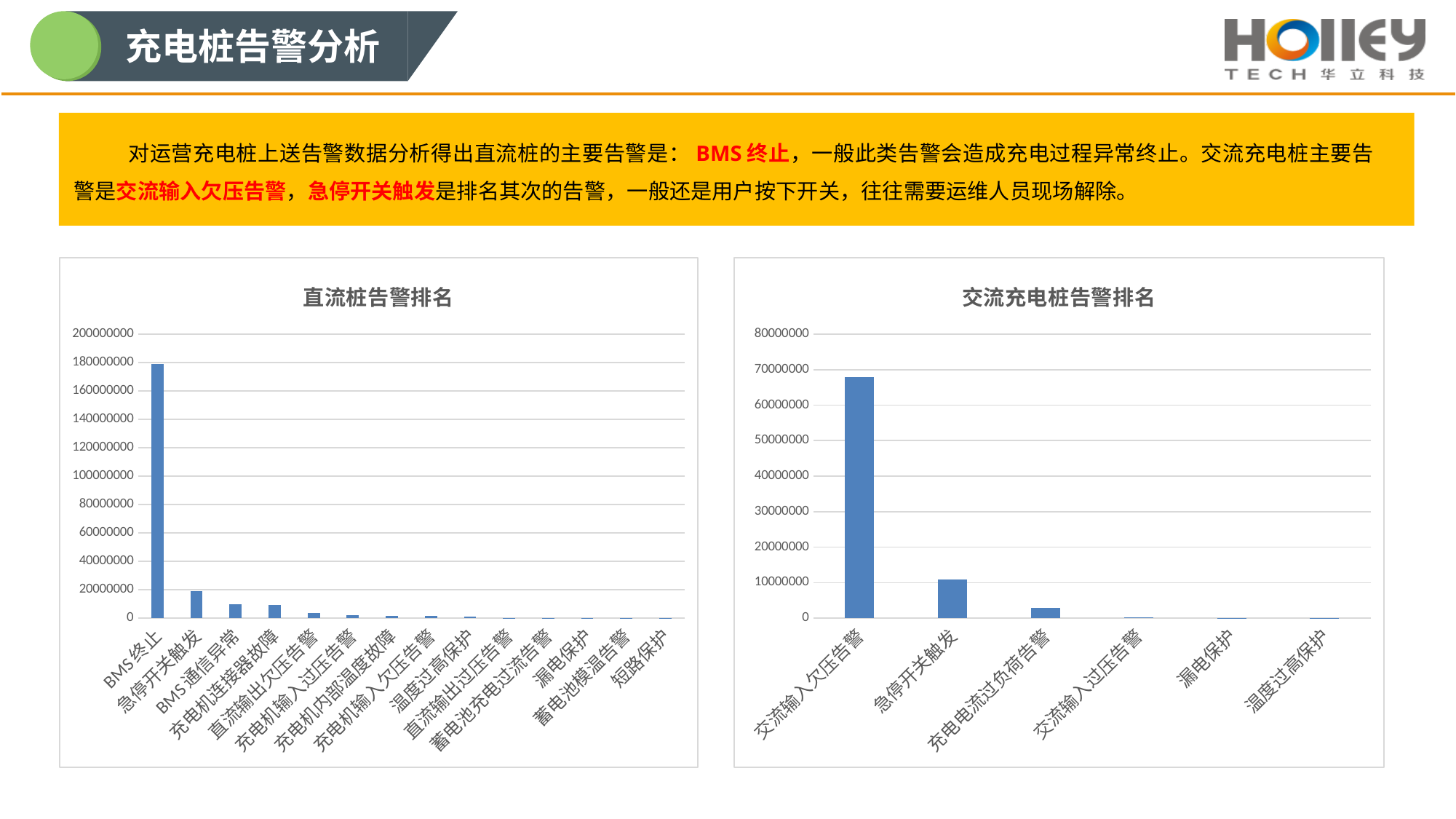
In the 直流桩告警排名 chart on the left, do the values rise or fall from left to right along the x axis? fall What kind of chart is the 直流桩告警排名 chart on the left? bar chart In the 直流桩告警排名 chart on the left, which is larger, 急停开关触发 or BMS通信异常? 急停开关触发 In the 交流充电桩告警排名 chart on the right, which category has the highest value? 交流输入欠压告警 In the 交流充电桩告警排名 chart on the right, which is larger, 急停开关触发 or 充电电流过负荷告警? 急停开关触发 How many categories are shown in the 交流充电桩告警排名 chart on the right? 6 In the 交流充电桩告警排名 chart on the right, is the value for 充电电流过负荷告警 greater or less than 10000000? less In the 交流充电桩告警排名 chart on the right, is the value for 交流输入欠压告警 greater or less than 60000000? greater How many categories are shown in the 直流桩告警排名 chart on the left? 14 In the 直流桩告警排名 chart on the left, which category has the highest value? BMS终止 In the 直流桩告警排名 chart on the left, is the value for BMS终止 greater or less than 160000000? greater